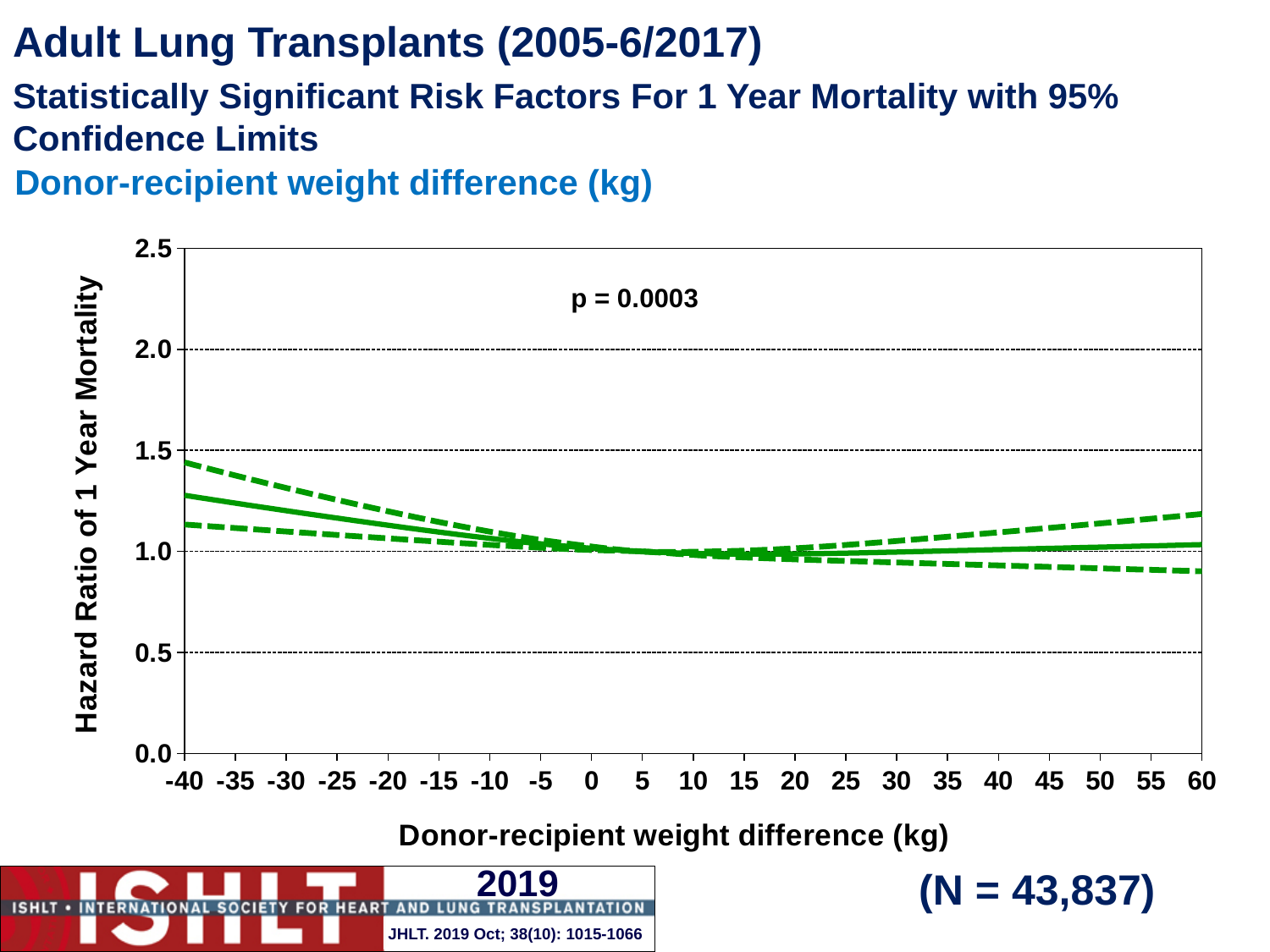
Is the hazard ratio (solid line) at a donor-recipient weight difference of -40 kg greater or less than 1.0? greater Is the hazard ratio (solid line) at a donor-recipient weight difference of -40 kg greater or less than 1.5? less How many tick labels are shown on the x axis? 21 Is the hazard ratio (solid line) larger at a donor-recipient weight difference of -40 kg or at 60 kg? -40 kg Is the upper confidence limit (upper dashed line) at a donor-recipient weight difference of -40 kg greater or less than 1.5? less What is the label of the y axis? Hazard Ratio of 1 Year Mortality Does the hazard ratio (solid line) rise or fall as the donor-recipient weight difference increases from -40 kg to 0 kg? fall What kind of chart is shown on the slide? line chart At which donor-recipient weight difference on the x axis is the hazard ratio (solid line) highest? -40 What is the p-value printed on the chart? p = 0.0003